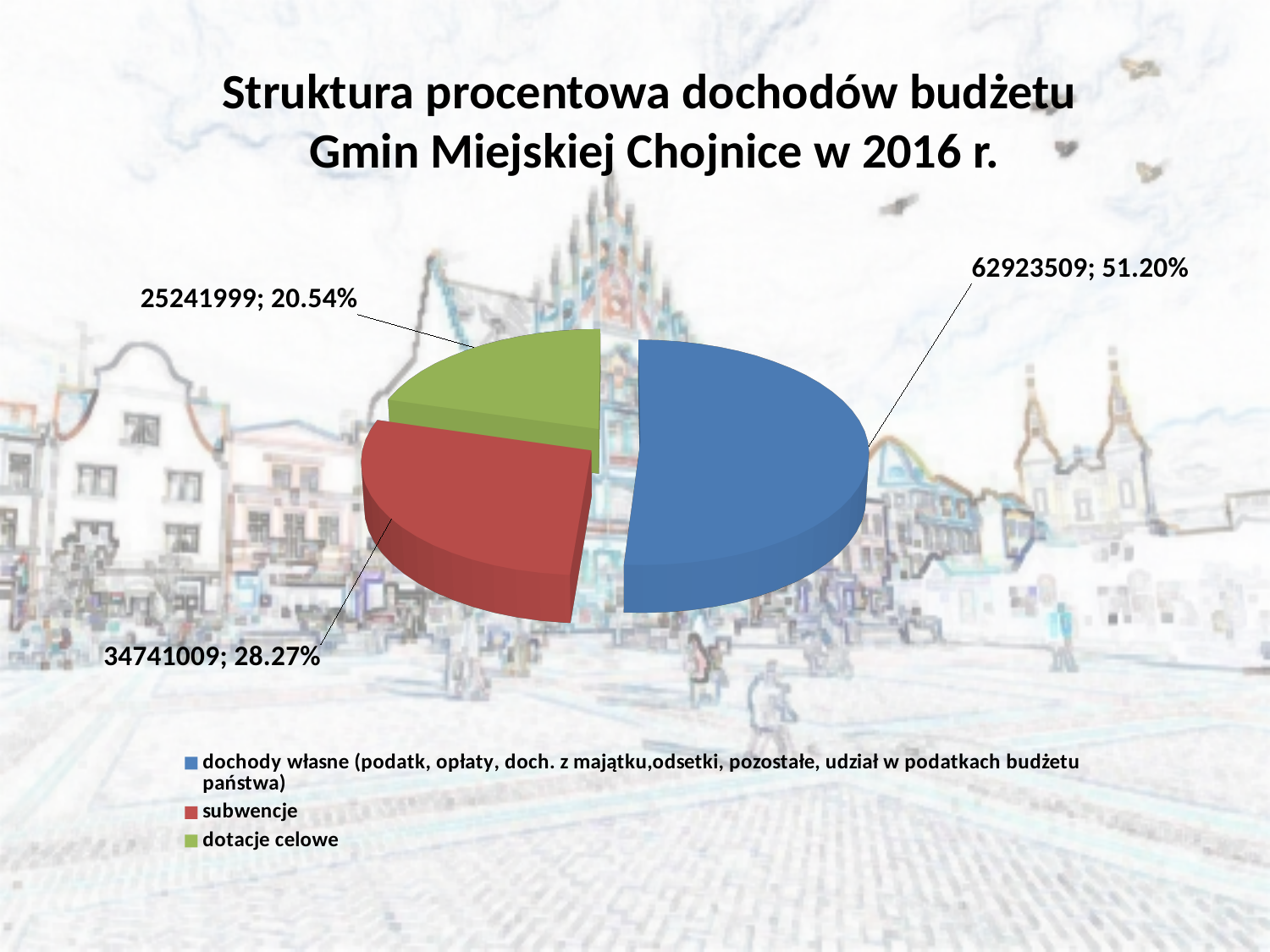
What kind of chart is shown on the slide? pie chart What value is shown for the 'dotacje celowe' slice? 25241999 What colour is the 'subwencje' slice? red Which is larger, the value for 'subwencje' or the value for 'dotacje celowe'? subwencje What percentage share does the 'dotacje celowe' slice have? 20.54% Which category has the largest slice of the pie? dochody własne Which category has the smallest slice of the pie? dotacje celowe How many slices does the pie chart have? 3 What percentage share does the 'dochody własne' slice have? 51.20% What value is shown for the 'subwencje' slice? 34741009 What is the difference between the value for 'dochody własne' and the value for 'subwencje'? 28182500 How many entries does the legend list? 3